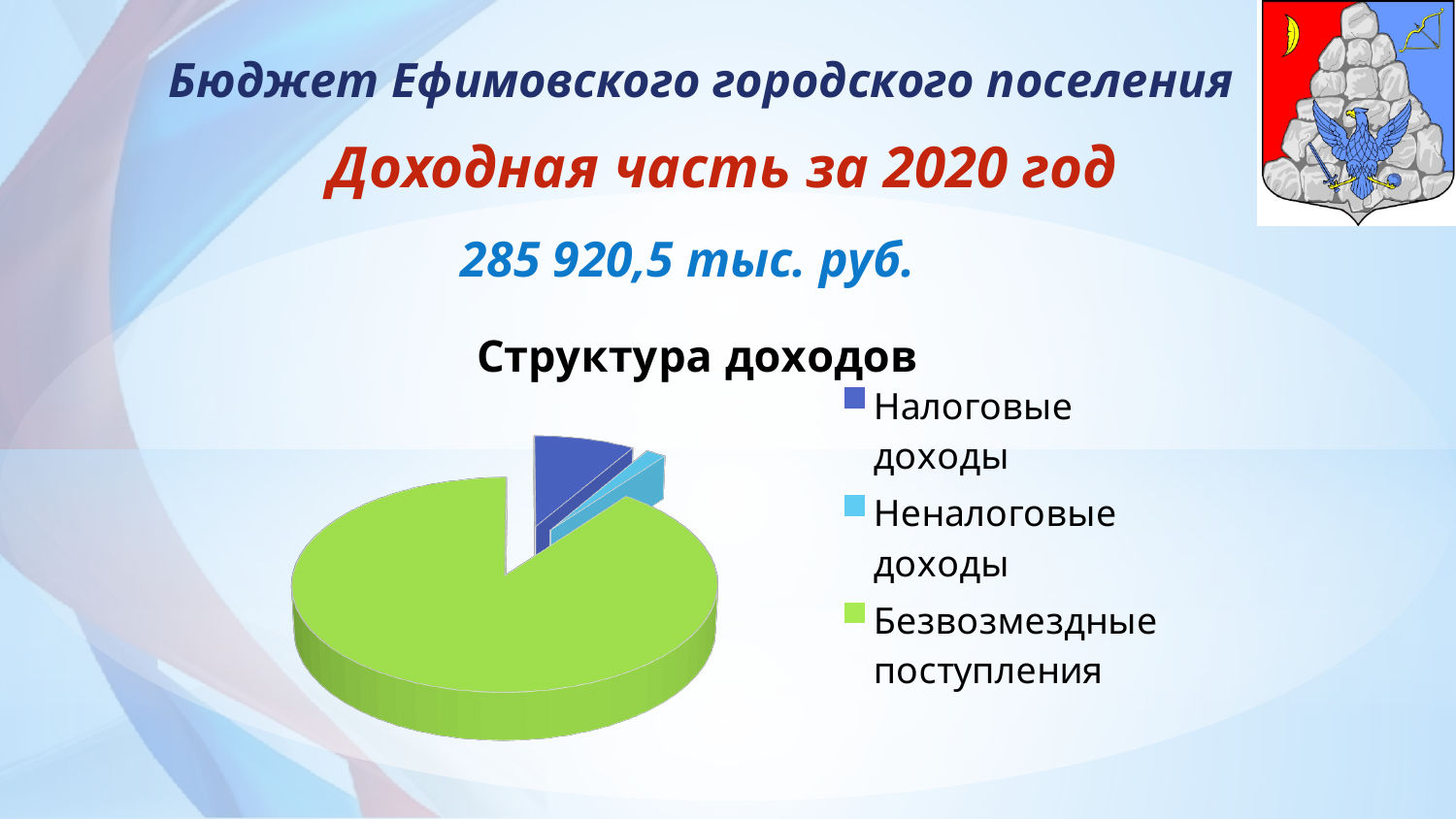
How many categories does the pie chart have? 3 Which category has the largest slice of the pie? Безвозмездные поступления What kind of chart is shown on the slide? pie chart What is the title of the chart? Структура доходов How many entries does the chart legend list? 3 What colour is the slice for Безвозмездные поступления? green Which slice is larger: Налоговые доходы or Неналоговые доходы? Налоговые доходы Which slice is larger: Безвозмездные поступления or Налоговые доходы? Безвозмездные поступления Which category has the smallest slice of the pie? Неналоговые доходы